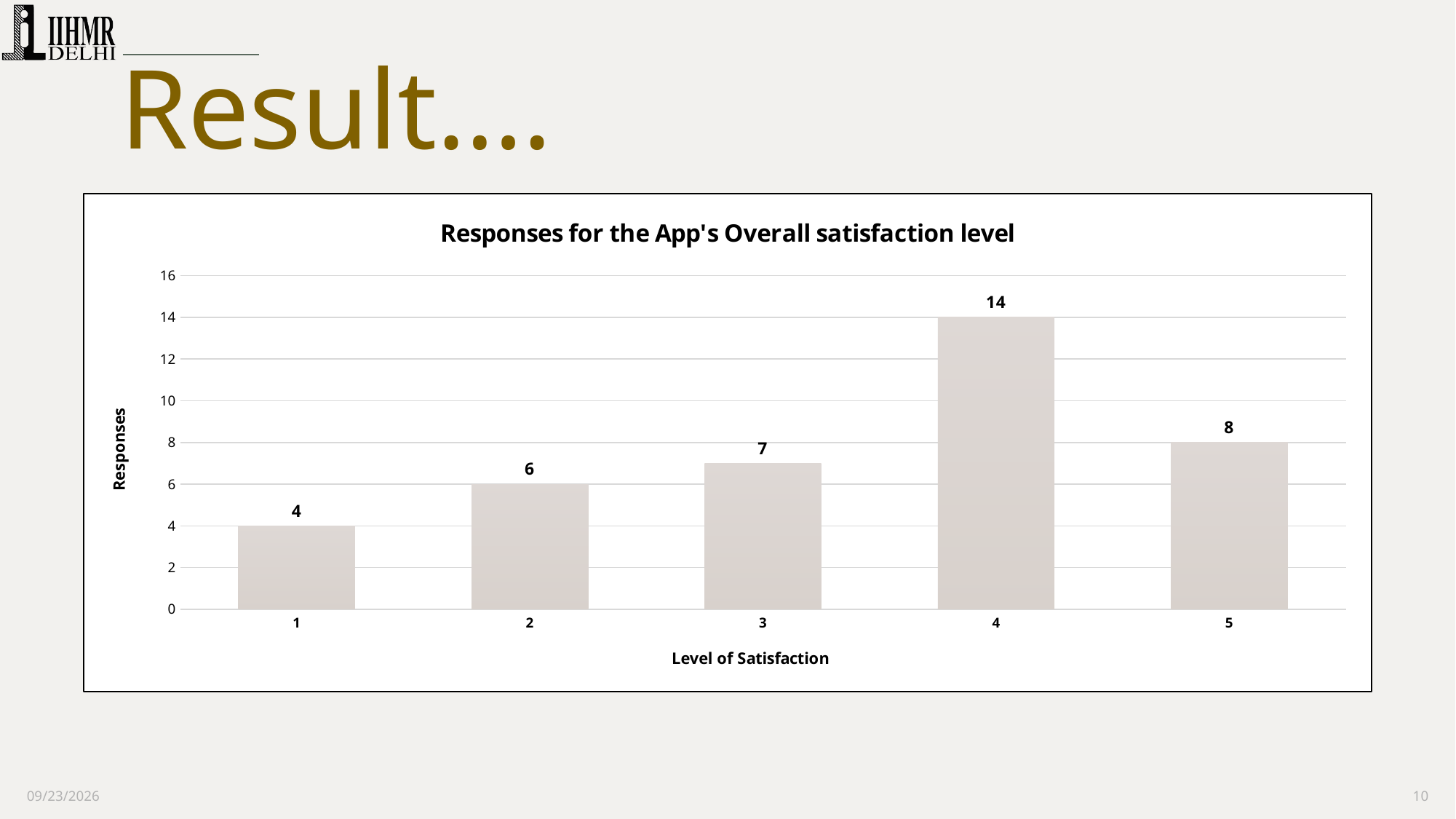
Which level of satisfaction received the fewest responses? 1 What is the difference in responses between satisfaction level 4 and satisfaction level 5? 6 Which has more responses, satisfaction level 2 or satisfaction level 5? Satisfaction level 5 What is the difference in responses between satisfaction level 3 and satisfaction level 2? 1 How many levels of satisfaction are shown on the x axis? 5 How many responses were recorded for satisfaction level 4? 14 What is the title of the chart? Responses for the App's Overall satisfaction level Which level of satisfaction received the most responses? 4 What kind of chart is shown on the slide? Bar chart How many responses were recorded for satisfaction level 1? 4 How many responses were recorded for satisfaction level 5? 8 Is the value for satisfaction level 4 greater or less than 12? greater